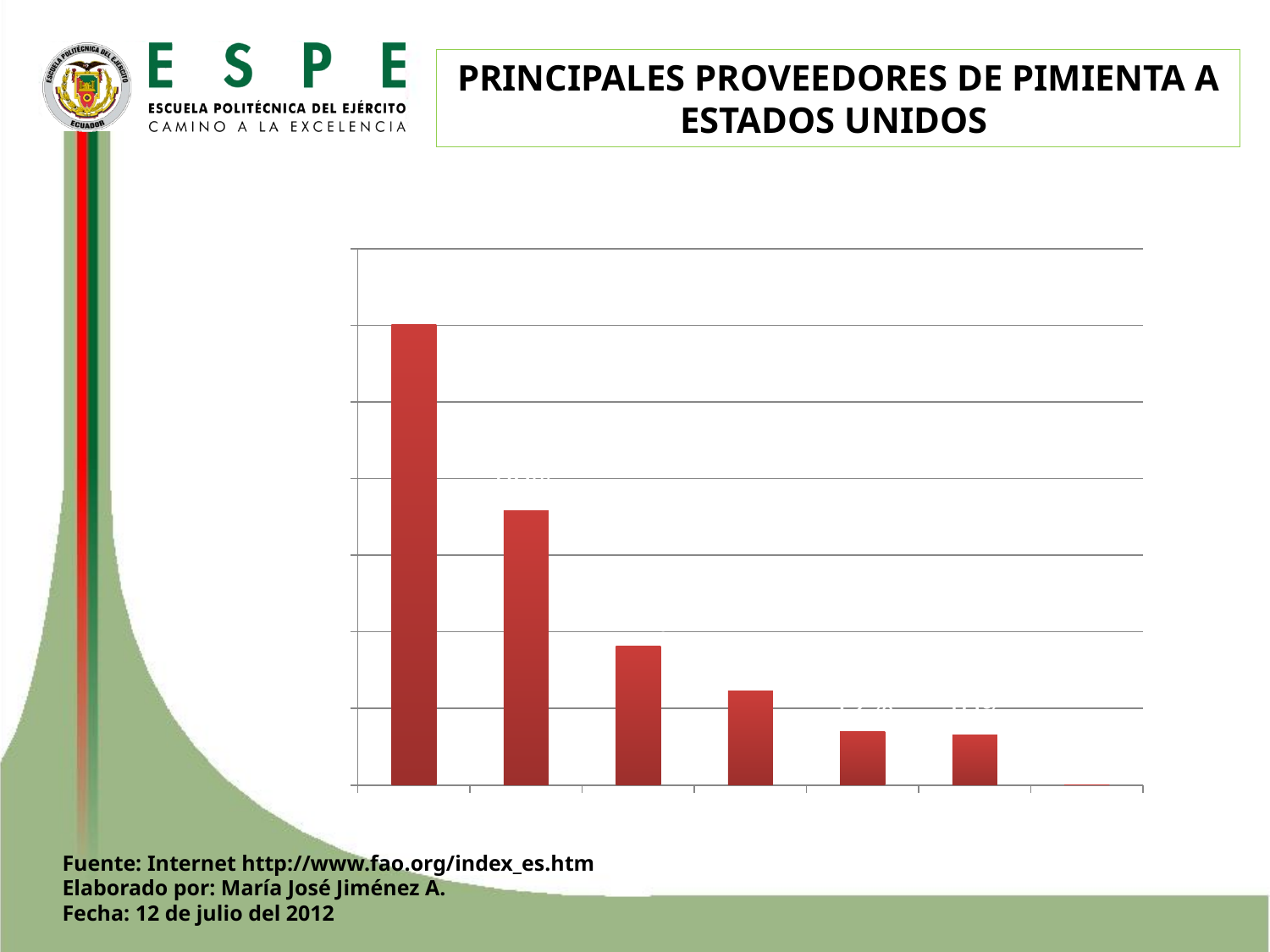
Is the leftmost bar taller or shorter than the second bar from the left? Taller What colour are the bars in the chart? Red What is the title shown above the chart on the slide? PRINCIPALES PROVEEDORES DE PIMIENTA A ESTADOS UNIDOS What kind of chart is shown on the slide? Bar chart Is the third bar from the left taller or shorter than the fourth bar? Taller Which bar in the chart is the tallest? The first (leftmost) bar Do the bar values rise or fall from left to right across the chart? Fall